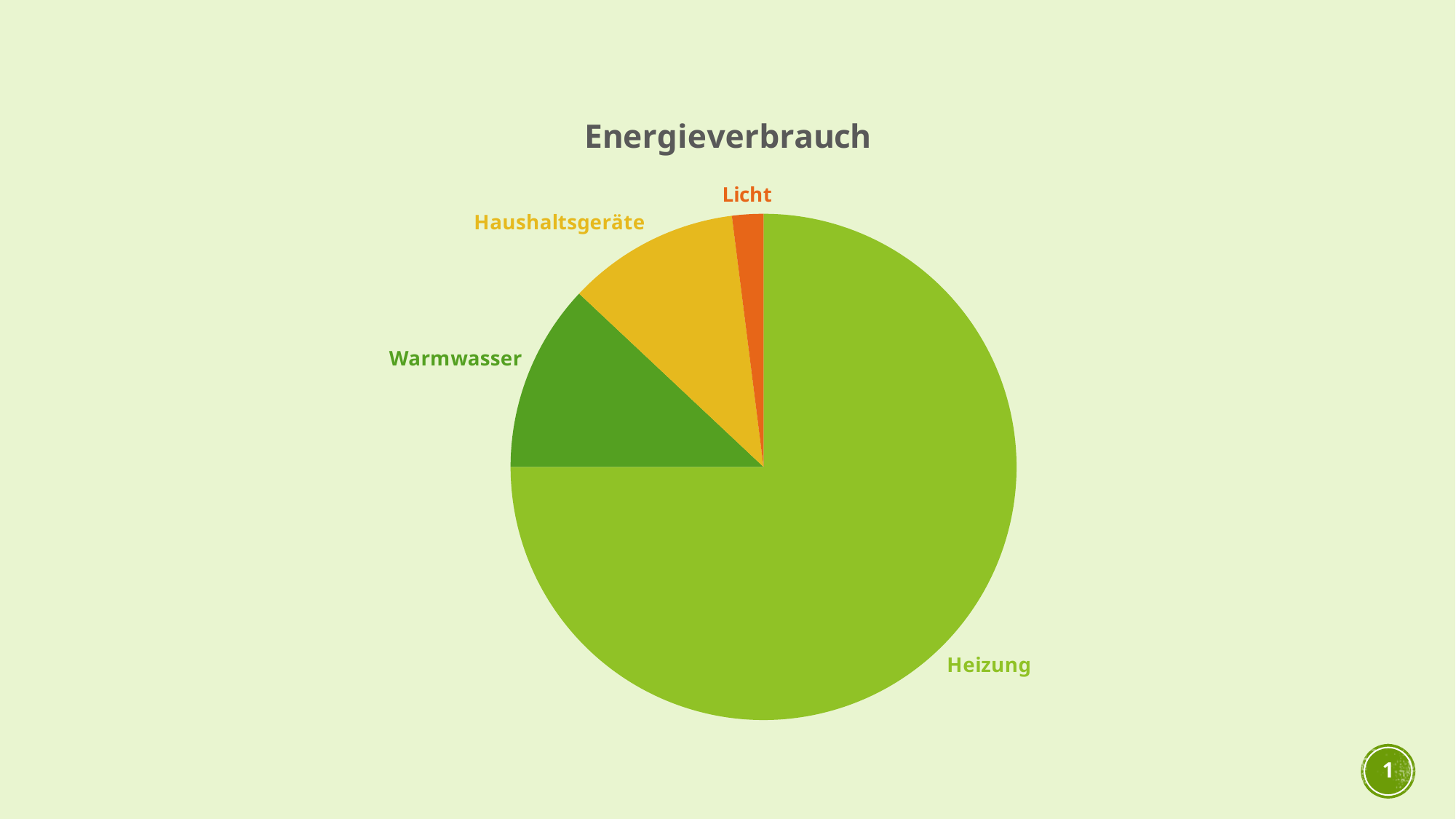
Does the Heizung slice make up more or less than half of the pie? more Which category has the smallest slice of the pie? Licht Which slice is larger, Heizung or Warmwasser? Heizung What is the title of the chart? Energieverbrauch How many slices does the pie chart have? 4 Which slice is larger, Warmwasser or Licht? Warmwasser Which category is shown in orange? Licht What kind of chart is shown on the slide? pie chart Which category has the largest slice of the pie? Heizung